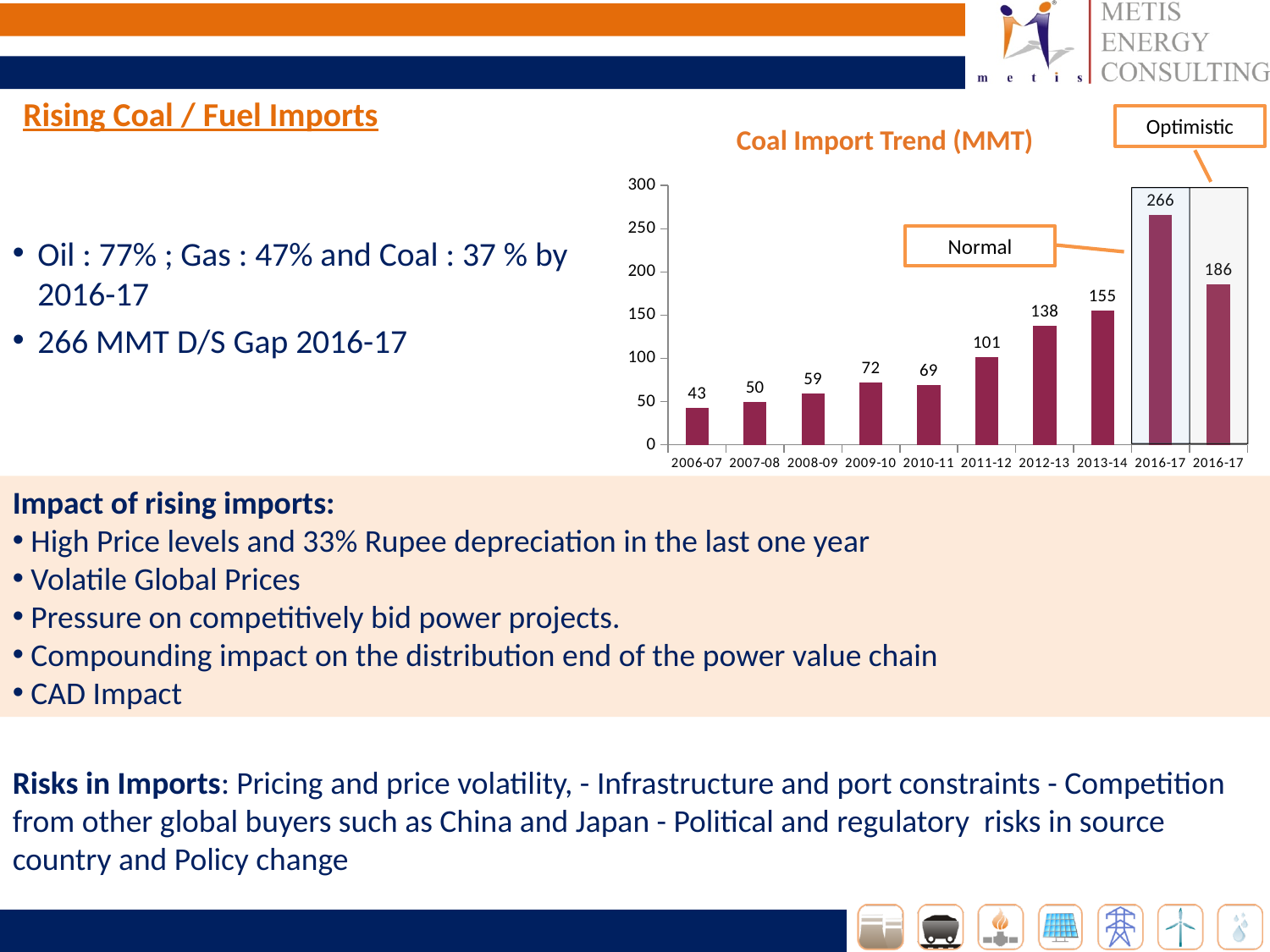
In the Coal Import Trend chart, which is larger: the value for 2009-10 or the value for 2010-11? 2009-10 What type of chart is the Coal Import Trend (MMT) chart? bar chart What is the coal import value for 2006-07 in the Coal Import Trend chart? 43 What is the coal import value for 2013-14 in the Coal Import Trend chart? 155 What is the difference between the 2016-17 Normal and 2016-17 Optimistic values in the Coal Import Trend chart? 80 What is the coal import value for 2012-13 in the Coal Import Trend chart? 138 How many bars are plotted in the Coal Import Trend chart? 10 Which year has the lowest coal import value in the Coal Import Trend chart? 2006-07 What is the title of the chart on the slide? Coal Import Trend (MMT) Which bar has the highest value in the Coal Import Trend chart? 2016-17 (Normal), 266 What is the difference between the 2013-14 and 2012-13 values in the Coal Import Trend chart? 17 What is the value of the 2016-17 bar labelled Optimistic in the Coal Import Trend chart? 186